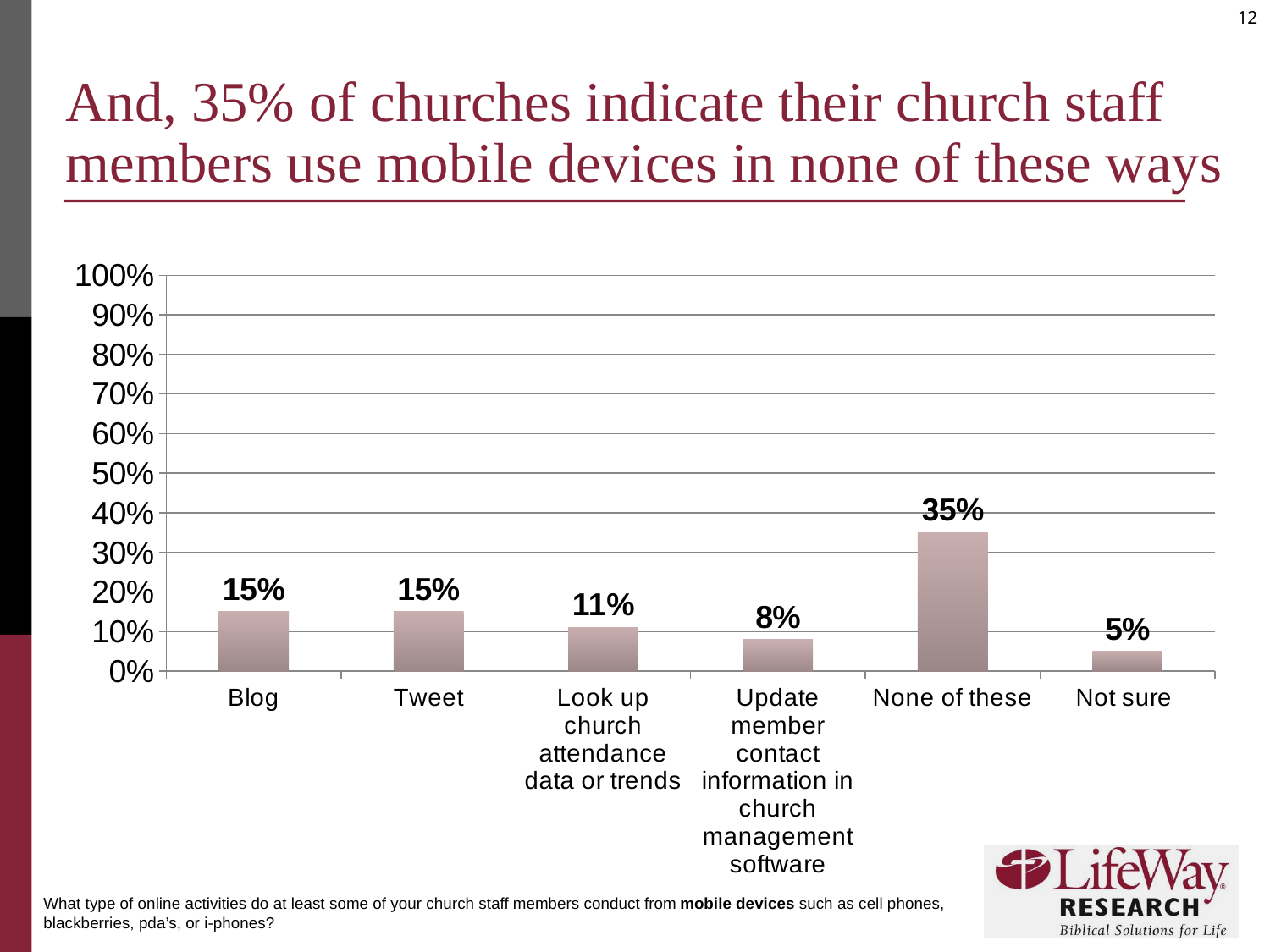
What kind of chart is shown on the slide? Bar chart Which is larger, the value for Tweet or the value for Update member contact information in church management software? Tweet What is the difference between the value for None of these and the value for Blog? 20% What percentage is shown for Not sure? 5% What is the highest value shown on the y axis? 100% What is the value shown for Tweet? 15% Which category has the highest value? None of these What percentage of churches indicate their staff members use mobile devices to Blog? 15% What percentage is shown for 'Look up church attendance data or trends'? 11% What is the value for 'Update member contact information in church management software'? 8% How many categories are shown on the x axis? 6 Which category has the lowest value? Not sure